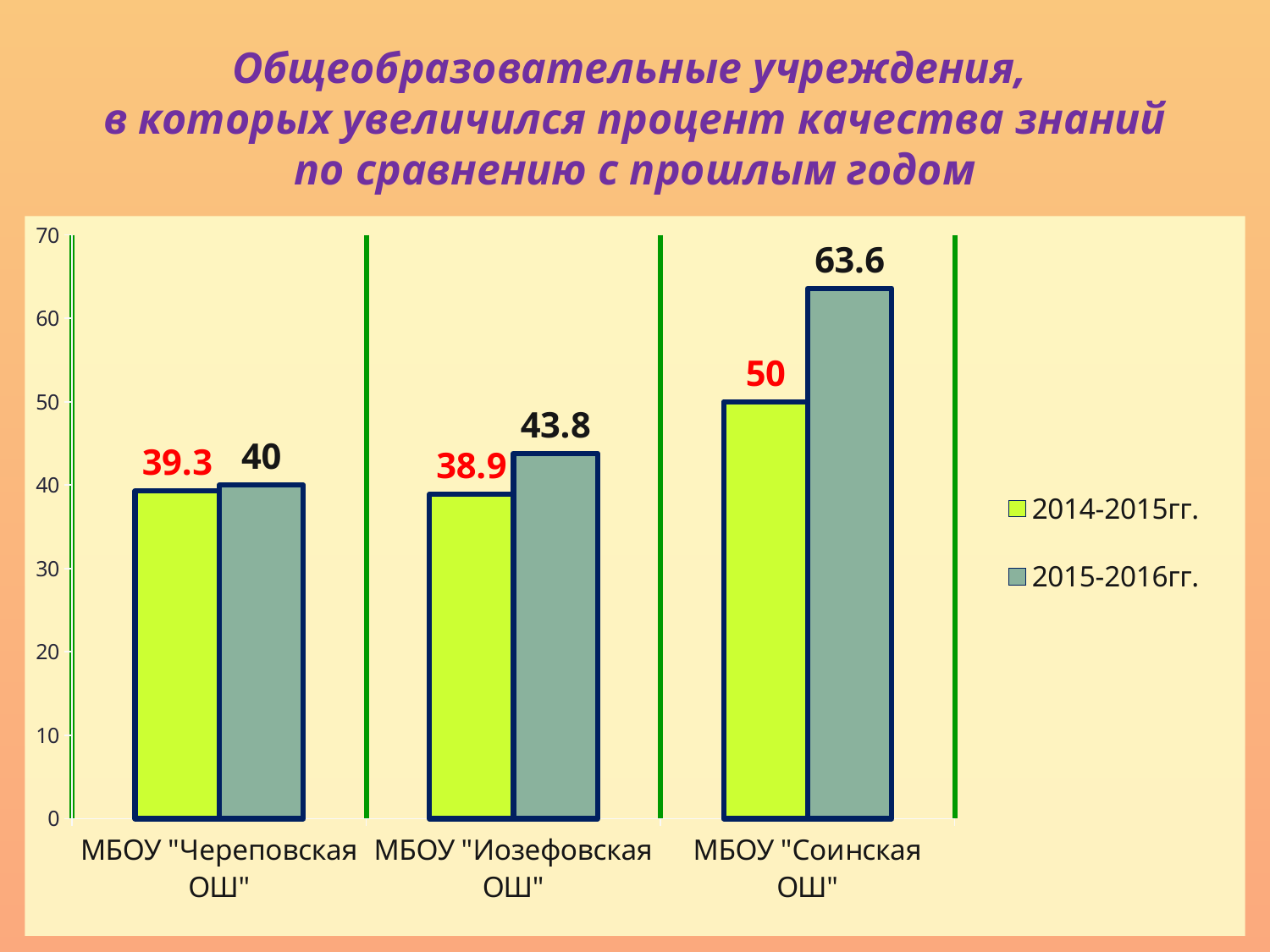
Which is larger: the 2014-2015гг. value for МБОУ "Соинская ОШ" or the 2015-2016гг. value for МБОУ "Иозефовская ОШ"? 2014-2015гг. value for МБОУ "Соинская ОШ" How many schools are shown on the x axis? 3 How many series does the legend list? 2 What is the value for МБОУ "Иозефовская ОШ" in the 2015-2016гг. series? 43.8 Which school has the lowest value in the 2014-2015гг. series? МБОУ "Иозефовская ОШ" What is the value for МБОУ "Соинская ОШ" in the 2015-2016гг. series? 63.6 Is the 2015-2016гг. value for МБОУ "Соинская ОШ" greater or less than 60? greater Which school has the highest value in the 2015-2016гг. series? МБОУ "Соинская ОШ" What is the difference between the 2015-2016гг. and 2014-2015гг. values for МБОУ "Соинская ОШ"? 13.6 What is the difference between the 2015-2016гг. and 2014-2015гг. values for МБОУ "Иозефовская ОШ"? 4.9 What is the value for МБОУ "Череповская ОШ" in the 2014-2015гг. series? 39.3 What kind of chart is shown on the slide? bar chart